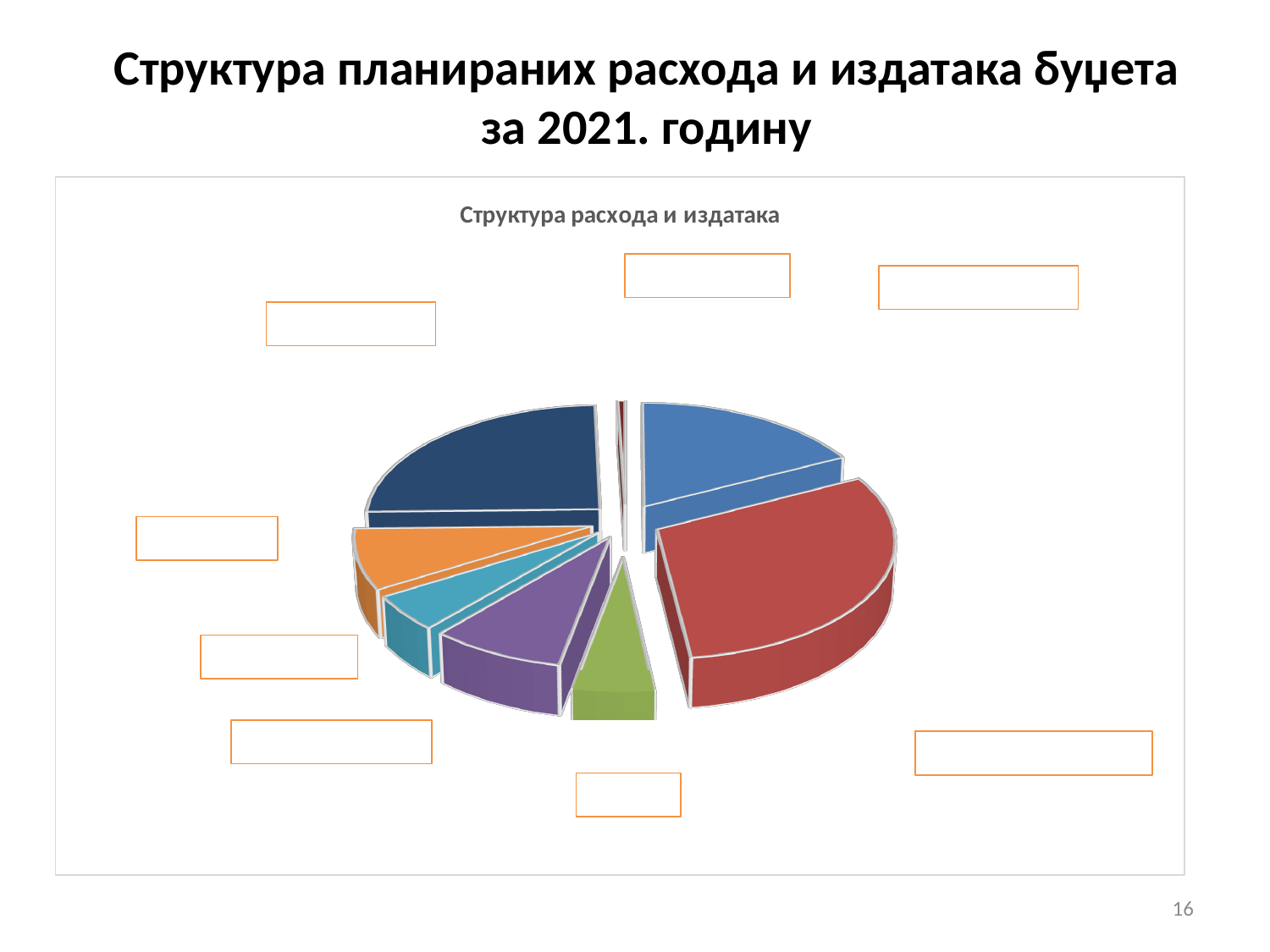
Which is larger, the purple slice or the teal slice? The purple slice Which is larger, the blue slice or the green slice? The blue slice What is the title printed inside the chart area? Структура расхода и издатака Which colour slice is the largest in the pie chart? Red Which is larger, the dark navy slice or the orange slice? The dark navy slice Does the chart display a legend? No What kind of chart is shown on the slide? Pie chart